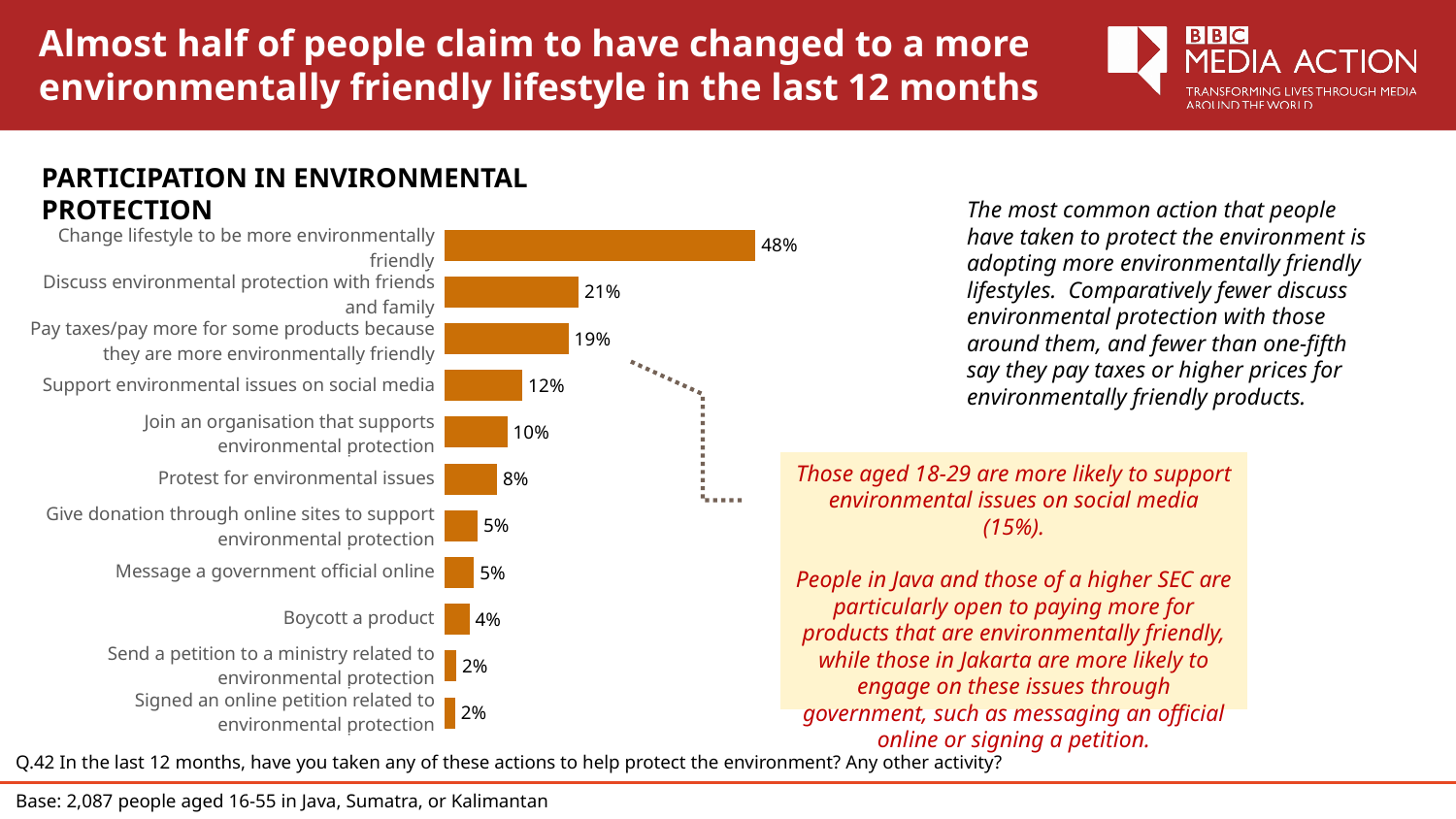
Which action has the highest percentage in the chart? Change lifestyle to be more environmentally friendly How many actions (categories) are shown in the chart? 11 What is the difference between 'Discuss environmental protection with friends and family' and 'Pay taxes/pay more for some products because they are more environmentally friendly'? 2% What percentage of people say they changed their lifestyle to be more environmentally friendly? 48% What colour are the bars in the chart? Orange What kind of chart is shown on the slide? Bar chart Which is larger: the value for 'Join an organisation that supports environmental protection' or the value for 'Protest for environmental issues'? Join an organisation that supports environmental protection What is the difference between the value for changing lifestyle and the value for protesting for environmental issues? 40% What is the value for 'Message a government official online'? 5% What is the title of the chart? PARTICIPATION IN ENVIRONMENTAL PROTECTION What percentage of people say they boycotted a product? 4% What is the value for 'Support environmental issues on social media'? 12%